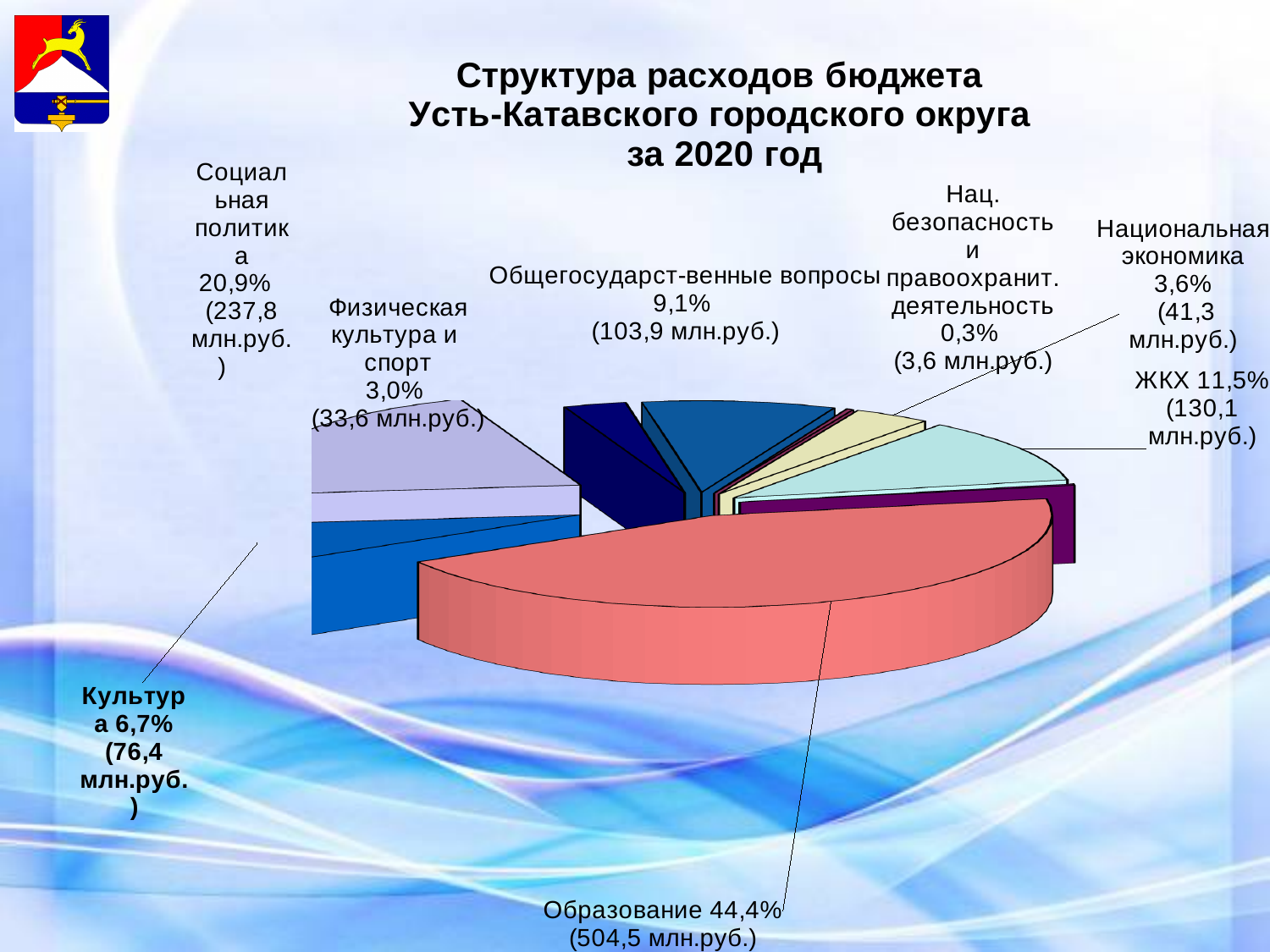
What is the amount in млн.руб. for Социальная политика? 237,8 млн.руб. What year does the chart title say the budget expenditure structure is for? 2020 Which category has the largest share of budget expenditure? Образование What percentage of the budget is spent on ЖКХ? 11,5% What share of budget expenditure goes to Образование? 44,4% What is the amount in млн.руб. for Общегосударственные вопросы? 103,9 млн.руб. What kind of chart is shown on the slide? pie chart What is the difference in percentage points between Социальная политика and ЖКХ? 9,4 Which is larger: the share for Культура or the share for Национальная экономика? Культура What is the amount in млн.руб. for Физическая культура и спорт? 33,6 млн.руб.